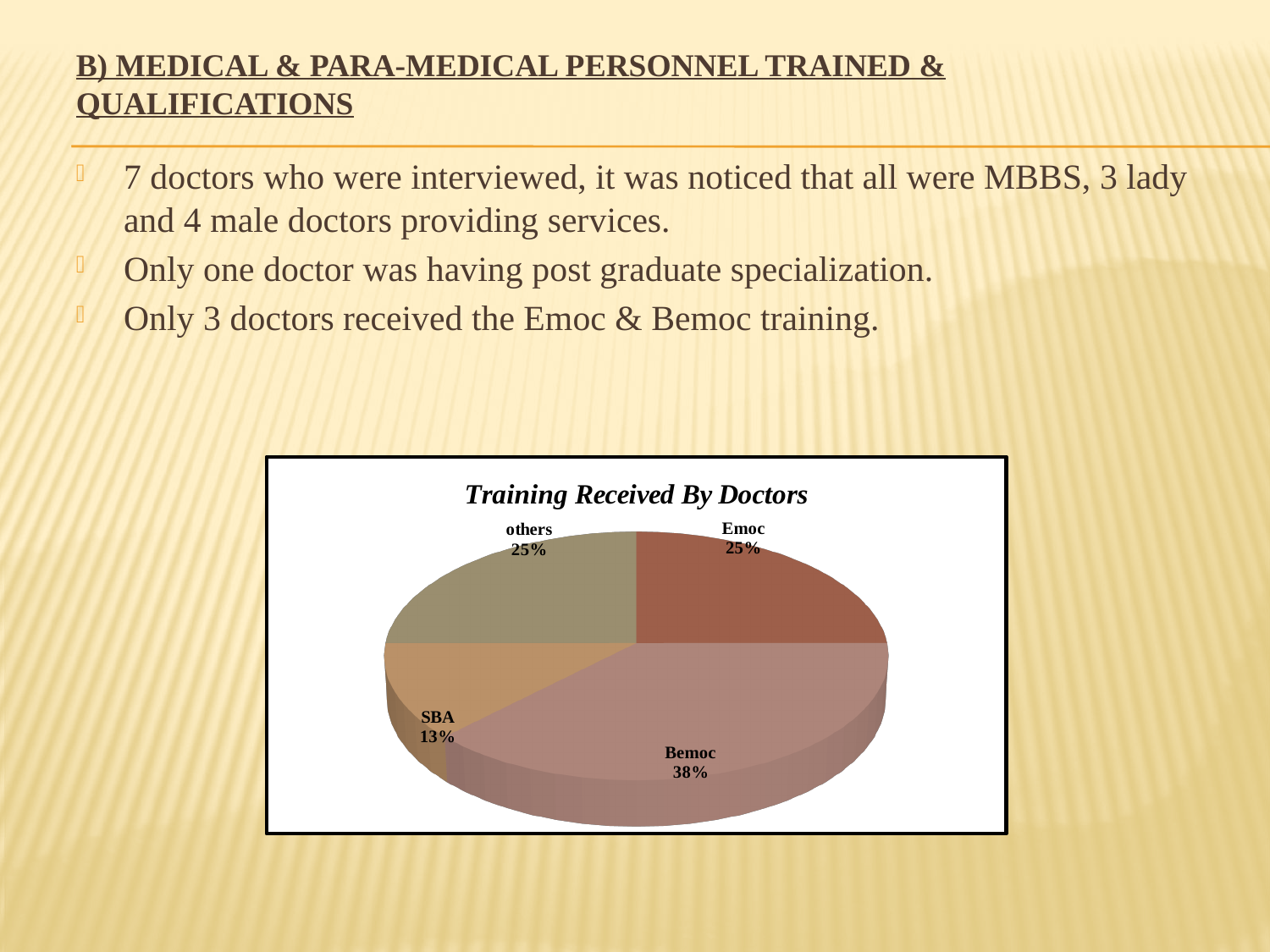
What kind of chart is shown on the slide? pie chart Which category has the smallest slice of the pie? SBA What is the difference in percentage points between Emoc and SBA? 12 What share of the pie does Bemoc represent? 38% How many categories are shown in the pie chart? 4 What is the value shown for Emoc? 25% Which category has the largest slice of the pie? Bemoc What is the value shown for others? 25% What is the difference in percentage points between Bemoc and SBA? 25 What share of the pie does SBA represent? 13% Which is larger, the share for Bemoc or the share for Emoc? Bemoc What is the title of the pie chart? Training Received By Doctors